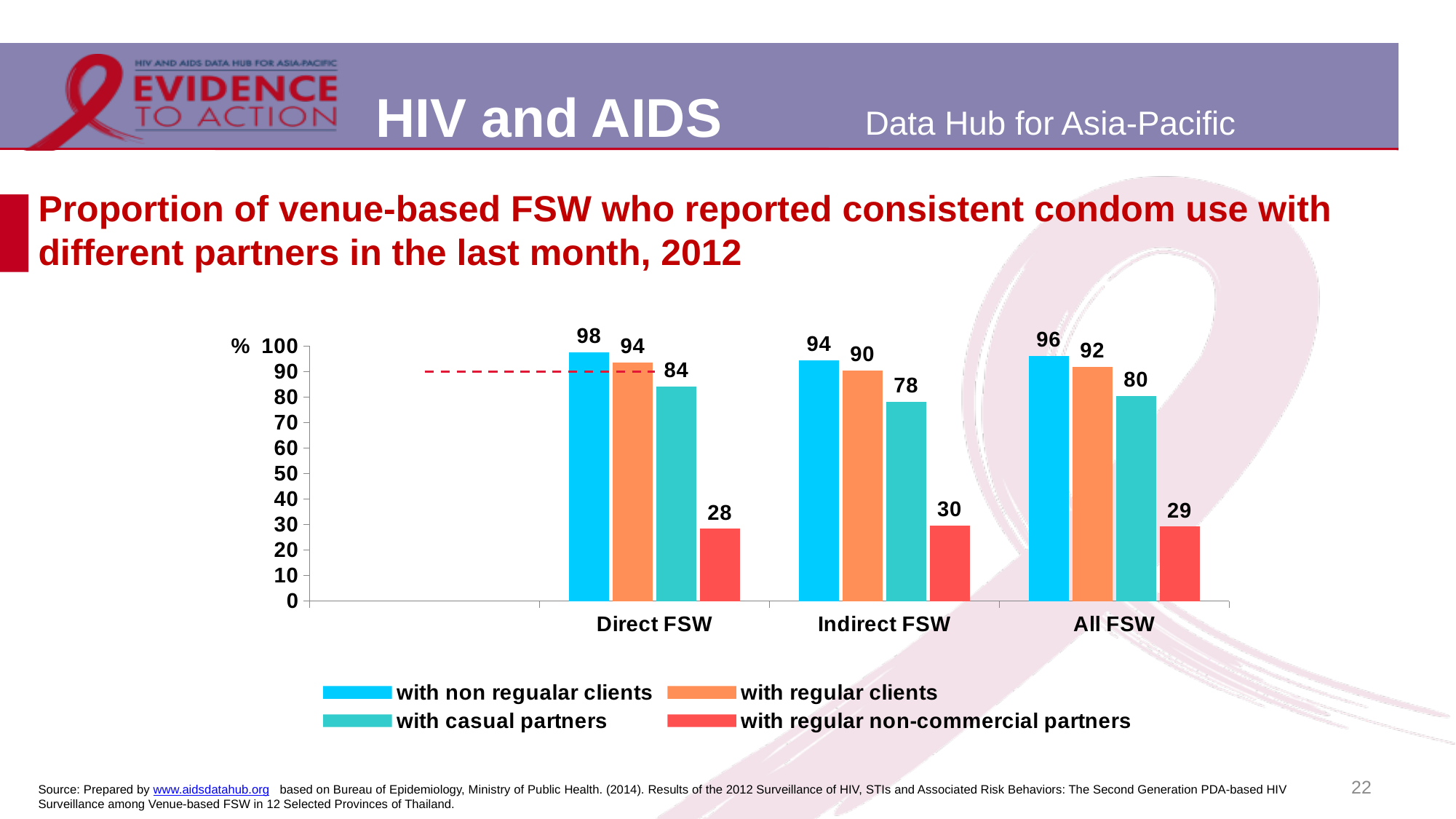
What is the unit label shown next to the y axis? % Is the value for Direct FSW with casual partners greater or less than 90? less What is the value for Direct FSW with non regular clients? 98 What is the value for All FSW with regular non-commercial partners? 29 What kind of chart is shown on the slide? bar chart Which is larger for All FSW: the value with regular clients or the value with casual partners? with regular clients How many categories are shown on the x axis? 3 Which category has the lowest value for the 'with regular non-commercial partners' series? Direct FSW What is the value for Indirect FSW with casual partners? 78 Which category has the highest value for the 'with regular clients' series? Direct FSW How many series does the legend list? 4 What is the difference between the 'with non regular clients' and 'with regular non-commercial partners' values for Indirect FSW? 64